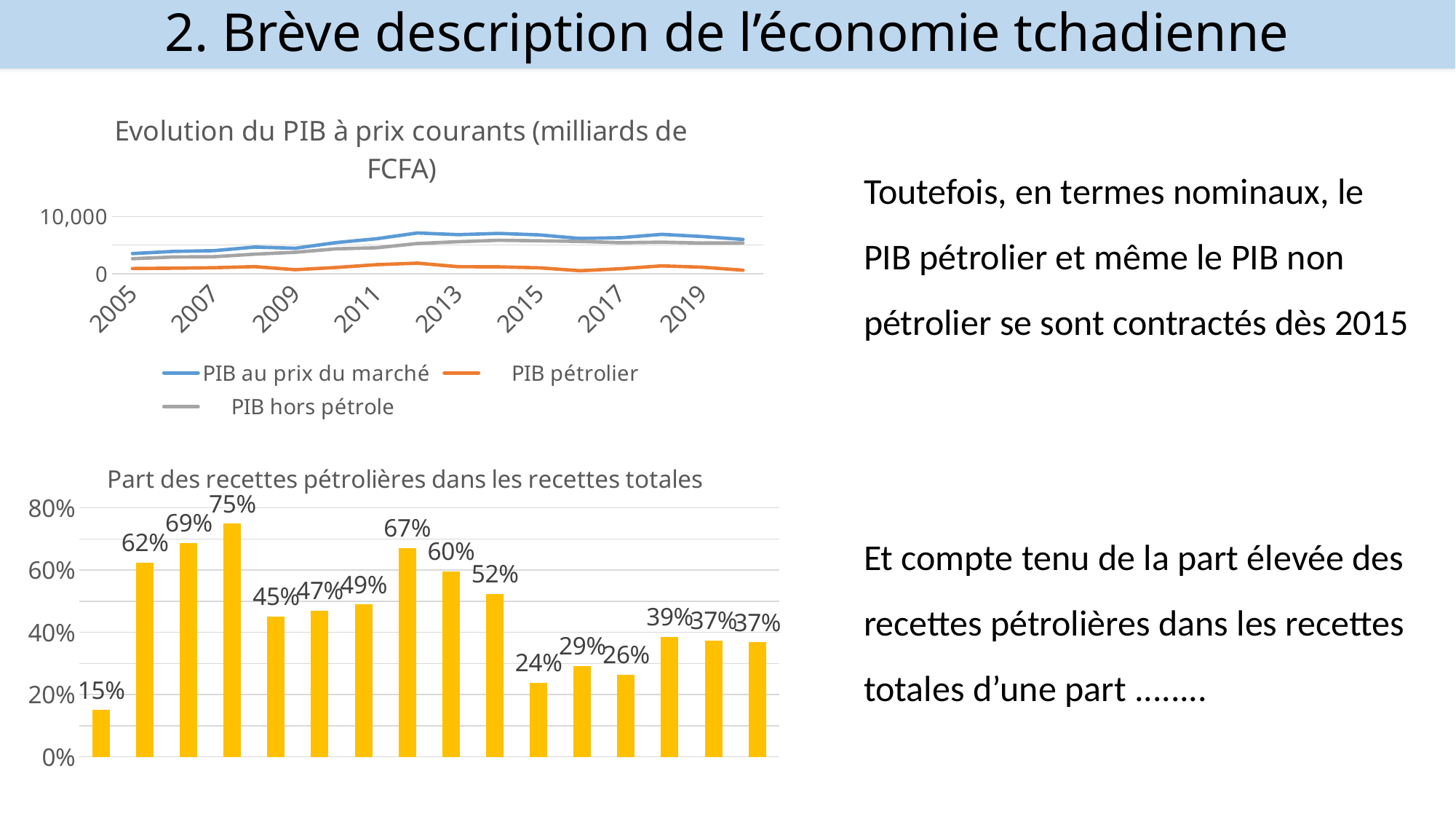
In the top chart 'Evolution du PIB à prix courants', which series is higher in 2011: PIB pétrolier or PIB hors pétrole? PIB hors pétrole In the top chart 'Evolution du PIB à prix courants', which series is drawn in orange? PIB pétrolier In the bottom chart 'Part des recettes pétrolières dans les recettes totales', what is the difference between the highest value (75%) and the lowest value (15%)? 60% In the bottom chart 'Part des recettes pétrolières dans les recettes totales', what is the lowest value shown? 15% What kind of chart is the top chart titled 'Evolution du PIB à prix courants (milliards de FCFA)'? line chart What kind of chart is the bottom chart titled 'Part des recettes pétrolières dans les recettes totales'? bar chart In the bottom chart 'Part des recettes pétrolières dans les recettes totales', what is the value of the first bar on the left? 15% In the bottom chart 'Part des recettes pétrolières dans les recettes totales', what is the highest value shown? 75% In the top chart 'Evolution du PIB à prix courants', is the value of PIB au prix du marché in 2013 greater or less than 10,000? less In the bottom chart 'Part des recettes pétrolières dans les recettes totales', what is the value of the last bar on the right? 37% How many bars are plotted in the bottom chart 'Part des recettes pétrolières dans les recettes totales'? 16 How many series does the legend of the top chart 'Evolution du PIB à prix courants' list? 3